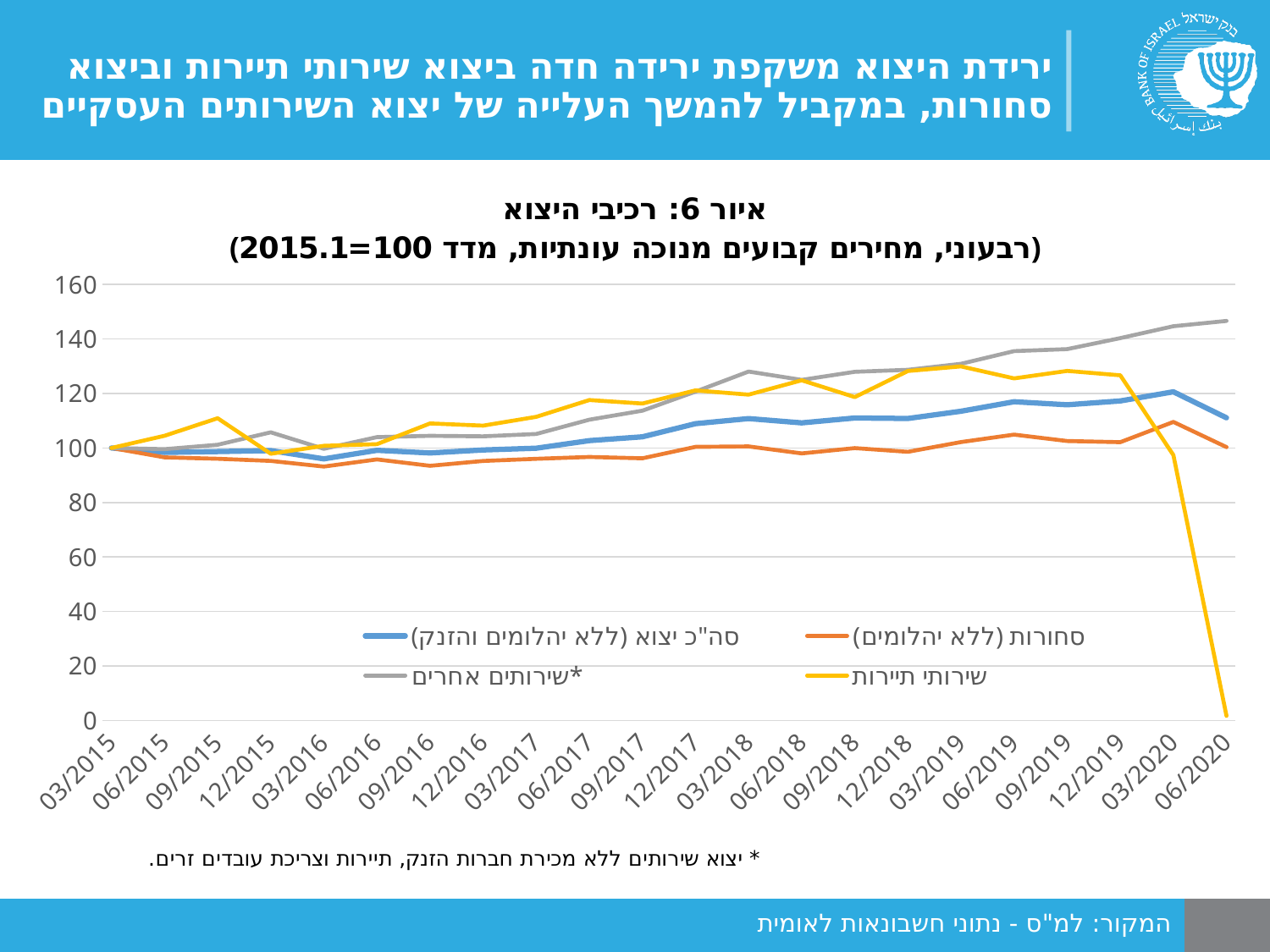
At 06/2020, which series has the highest value? שירותים אחרים How many series does the legend list? 4 What is the title of the chart? איור 6: רכיבי היצוא How many quarterly points are plotted along the x axis? 22 At 06/2020, which is larger: שירותים אחרים or שירותי תיירות? שירותים אחרים At 06/2020, which series has the lowest value? שירותי תיירות Is the value for סחורות (ללא יהלומים) at 06/2020 greater or less than 120? less Does the שירותים אחרים series generally rise or fall from 03/2015 to 06/2020? rise Is the value for שירותי תיירות at 06/2020 greater or less than 20? less Is the value for שירותים אחרים at 06/2020 greater or less than 140? greater What kind of chart is shown on the slide? line chart